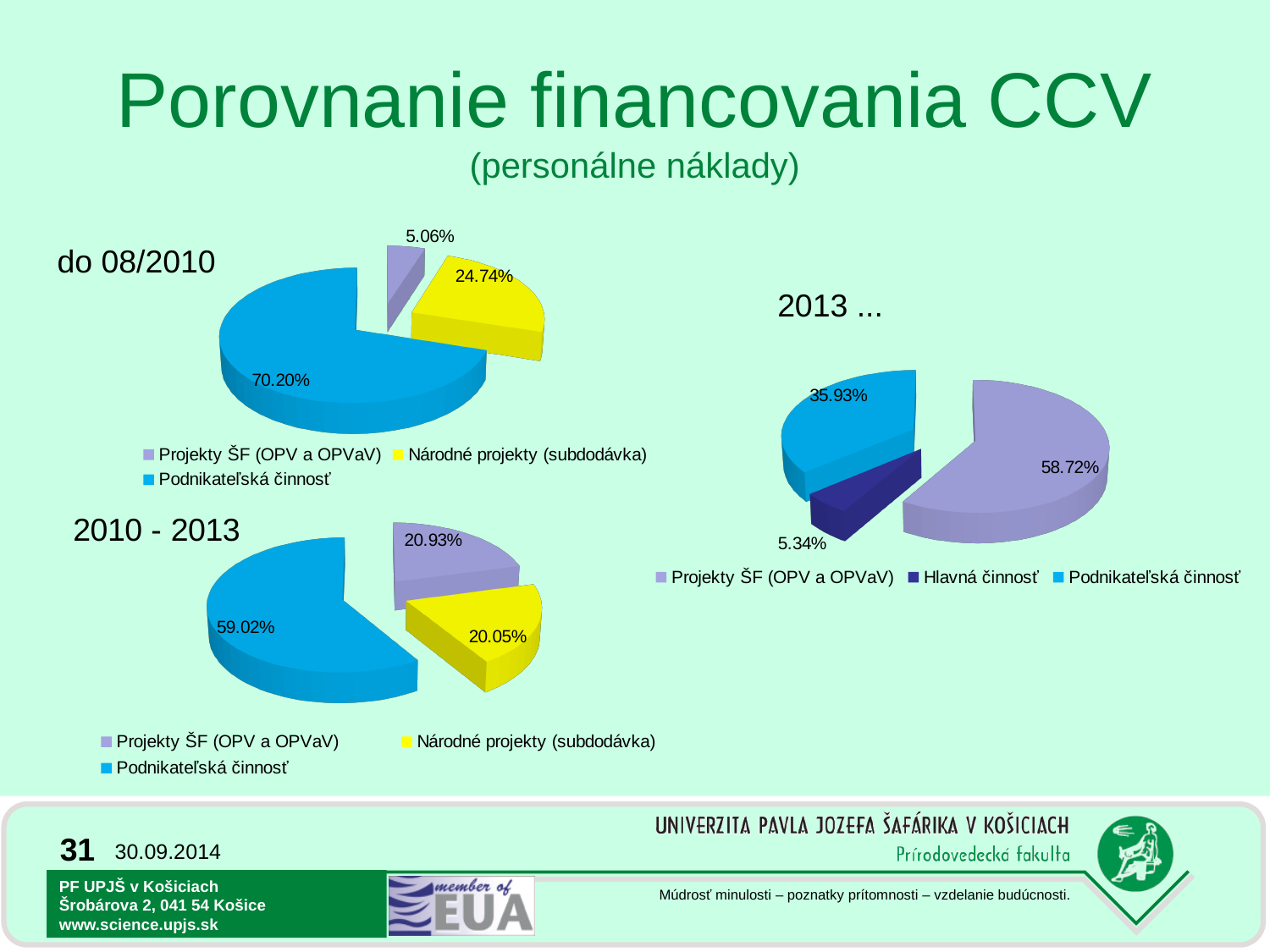
In the 'do 08/2010' pie chart, what share does Podnikateľská činnosť have? 70.20% What type of chart is used for the 'do 08/2010' data? Pie chart How many entries does the legend of the '2013 ...' chart list? 3 In the 'do 08/2010' pie chart, what share does Projekty ŠF (OPV a OPVaV) have? 5.06% In the '2013 ...' pie chart, what share does Hlavná činnosť have? 5.34% In the '2013 ...' pie chart, which is larger: Podnikateľská činnosť or Hlavná činnosť? Podnikateľská činnosť In the '2010 - 2013' pie chart, which category has the smallest share? Národné projekty (subdodávka) In the 'do 08/2010' pie chart, what is the difference between the shares of Podnikateľská činnosť and Národné projekty (subdodávka)? 45.46% In the '2010 - 2013' pie chart, what share does Národné projekty (subdodávka) have? 20.05% How many slices does the '2010 - 2013' pie chart have? 3 In the '2013 ...' pie chart, which category has the largest share? Projekty ŠF (OPV a OPVaV) In the '2013 ...' pie chart, which category is shown in dark blue? Hlavná činnosť